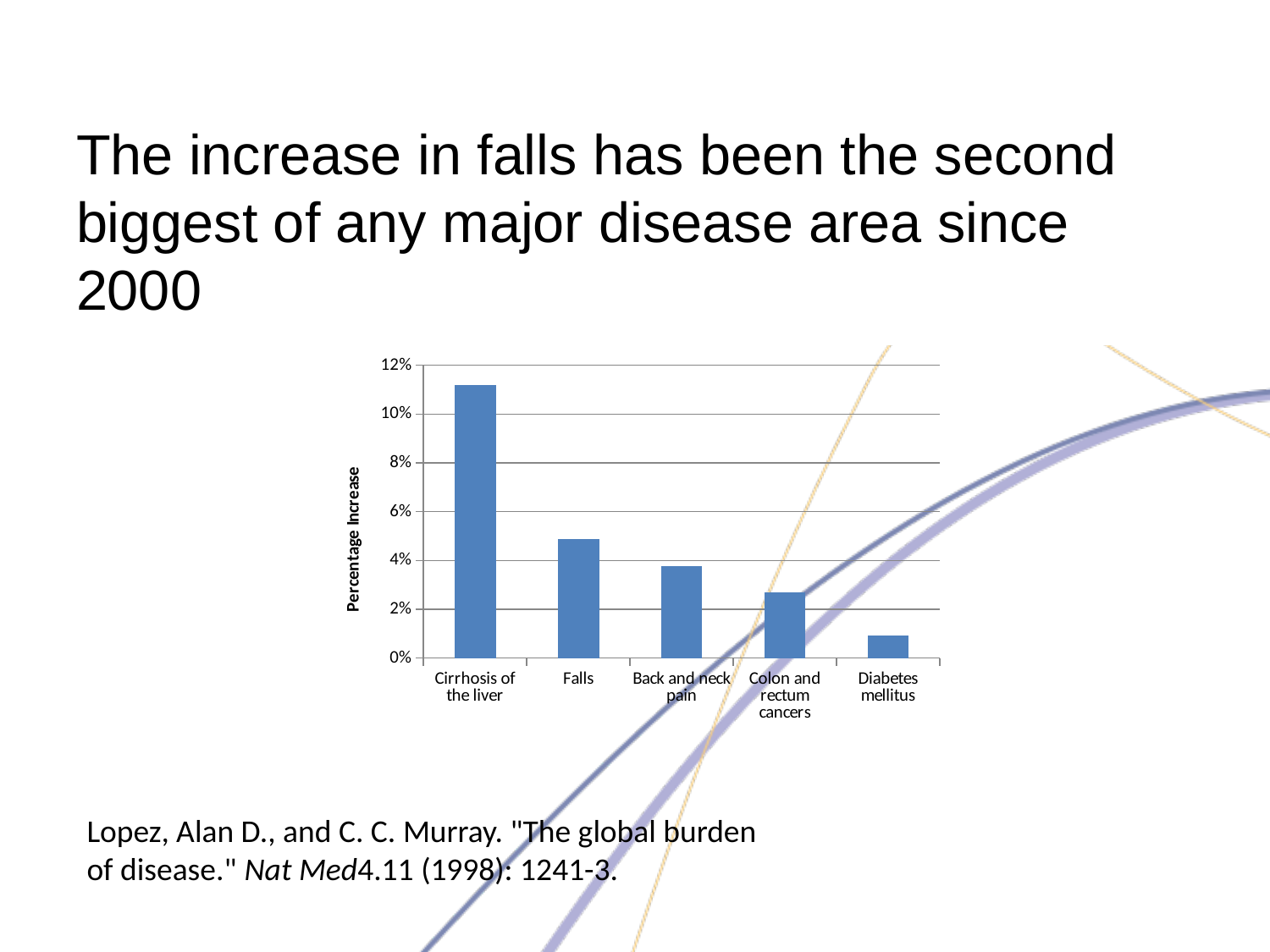
Which category has the lowest percentage increase? Diabetes mellitus What is the title of the vertical axis of the chart? Percentage Increase Is the value for Back and neck pain greater or less than 4%? less What kind of chart is shown on the slide? bar chart How many categories are shown on the x axis of the chart? 5 Is the value for Cirrhosis of the liver greater or less than 10%? greater Which category has the highest percentage increase? Cirrhosis of the liver Do the bar values rise or fall from left to right along the x axis? fall Is the value for Diabetes mellitus greater or less than 2%? less Which is larger, the value for Falls or the value for Colon and rectum cancers? Falls